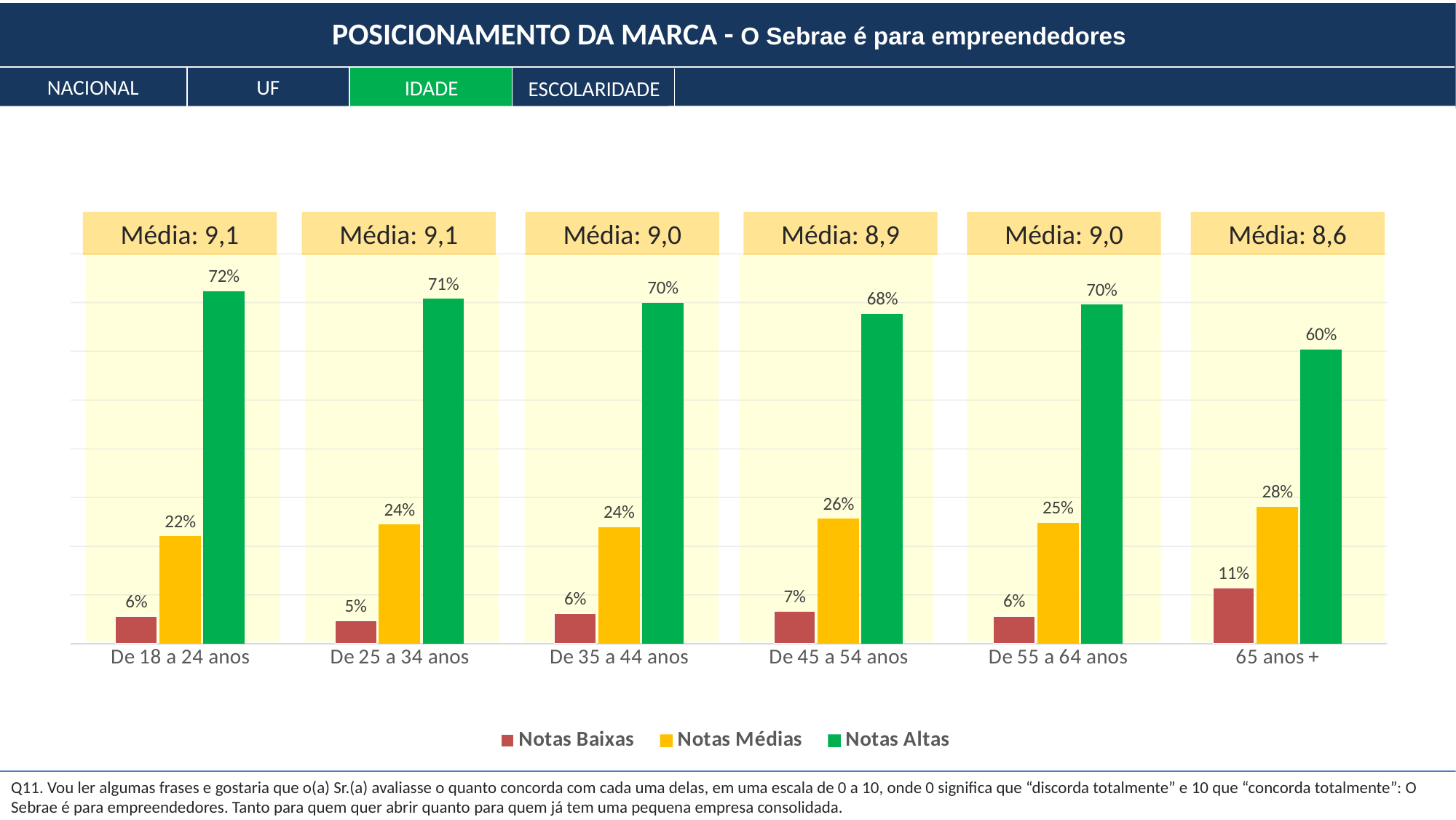
What kind of chart is shown on the slide? Bar chart What is the Notas Baixas value for 65 anos +? 11% Which age group has the lowest Notas Altas value? 65 anos + Which age group has the highest Notas Altas value? De 18 a 24 anos What is the difference between the Notas Altas values for De 18 a 24 anos and 65 anos +? 12% Which is larger: the Notas Médias value for 65 anos + or for De 25 a 34 anos? 65 anos + Which colour represents Notas Altas in the legend? Green What is the Notas Médias value for De 45 a 54 anos? 26% How many series does the legend list? 3 What is the Média shown above the 65 anos + group? 8,6 How many age groups are shown on the x axis? 6 What is the Notas Altas value for De 18 a 24 anos? 72%